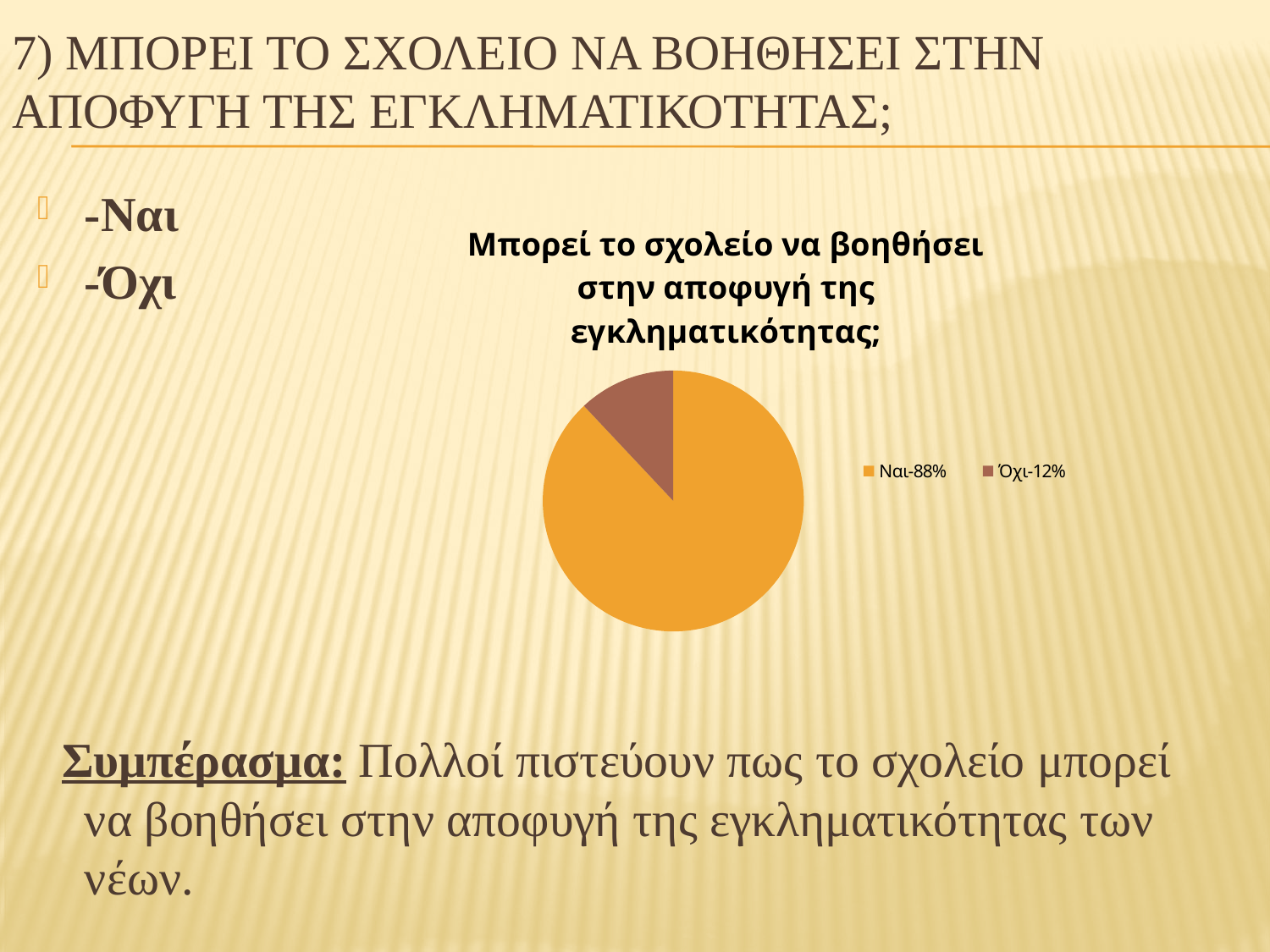
What share of the pie does the 'Ναι' slice represent? 88% Which slice is the smallest in the pie chart? Όχι What is the difference in percentage points between the 'Ναι' and 'Όχι' slices? 76 Which is larger, the 'Ναι' slice or the 'Όχι' slice? Ναι What colour is the 'Όχι' slice in the pie chart? brown What kind of chart is shown on the slide? pie chart Which slice is the largest in the pie chart? Ναι What share of the pie does the 'Όχι' slice represent? 12% How many slices does the pie chart have? 2 What is the title of the chart? Μπορεί το σχολείο να βοηθήσει στην αποφυγή της εγκληματικότητας; How many entries does the legend list? 2